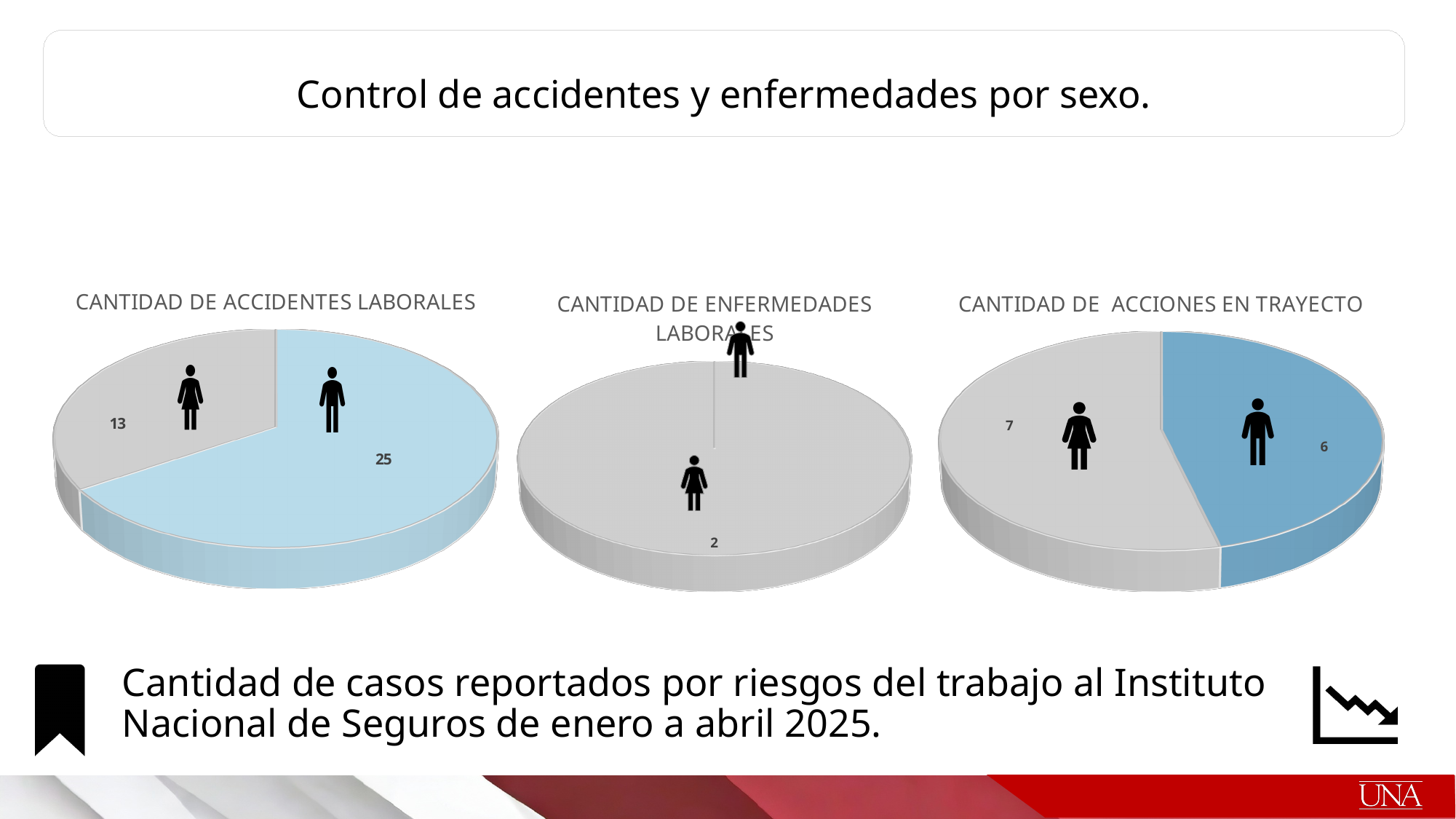
In the 'CANTIDAD DE ACCIONES EN TRAYECTO' chart, what value is printed on the blue slice with the male figure? 6 In the 'CANTIDAD DE ACCIONES EN TRAYECTO' chart, what is the total of the two slice values? 13 In the 'CANTIDAD DE ACCIONES EN TRAYECTO' chart, what value is printed on the grey slice with the female figure? 7 How many pie charts are shown on the slide? 3 In the 'CANTIDAD DE ACCIONES EN TRAYECTO' chart, is the value of the slice with the female figure larger or smaller than the value of the slice with the male figure? larger In the 'CANTIDAD DE ACCIDENTES LABORALES' chart, what value is printed on the light blue slice with the male figure? 25 In the 'CANTIDAD DE ACCIDENTES LABORALES' chart, what value is printed on the grey slice with the female figure? 13 In the 'CANTIDAD DE ACCIDENTES LABORALES' chart, which slice has the highest value? the light blue slice with the male figure (25) In the 'CANTIDAD DE ACCIDENTES LABORALES' chart, what is the total of the two slice values? 38 In the 'CANTIDAD DE ENFERMEDADES LABORALES' chart, what value is printed on the slice with the female figure? 2 What kind of chart is 'CANTIDAD DE ACCIDENTES LABORALES'? pie chart In the 'CANTIDAD DE ACCIDENTES LABORALES' chart, what is the difference between the two slice values? 12